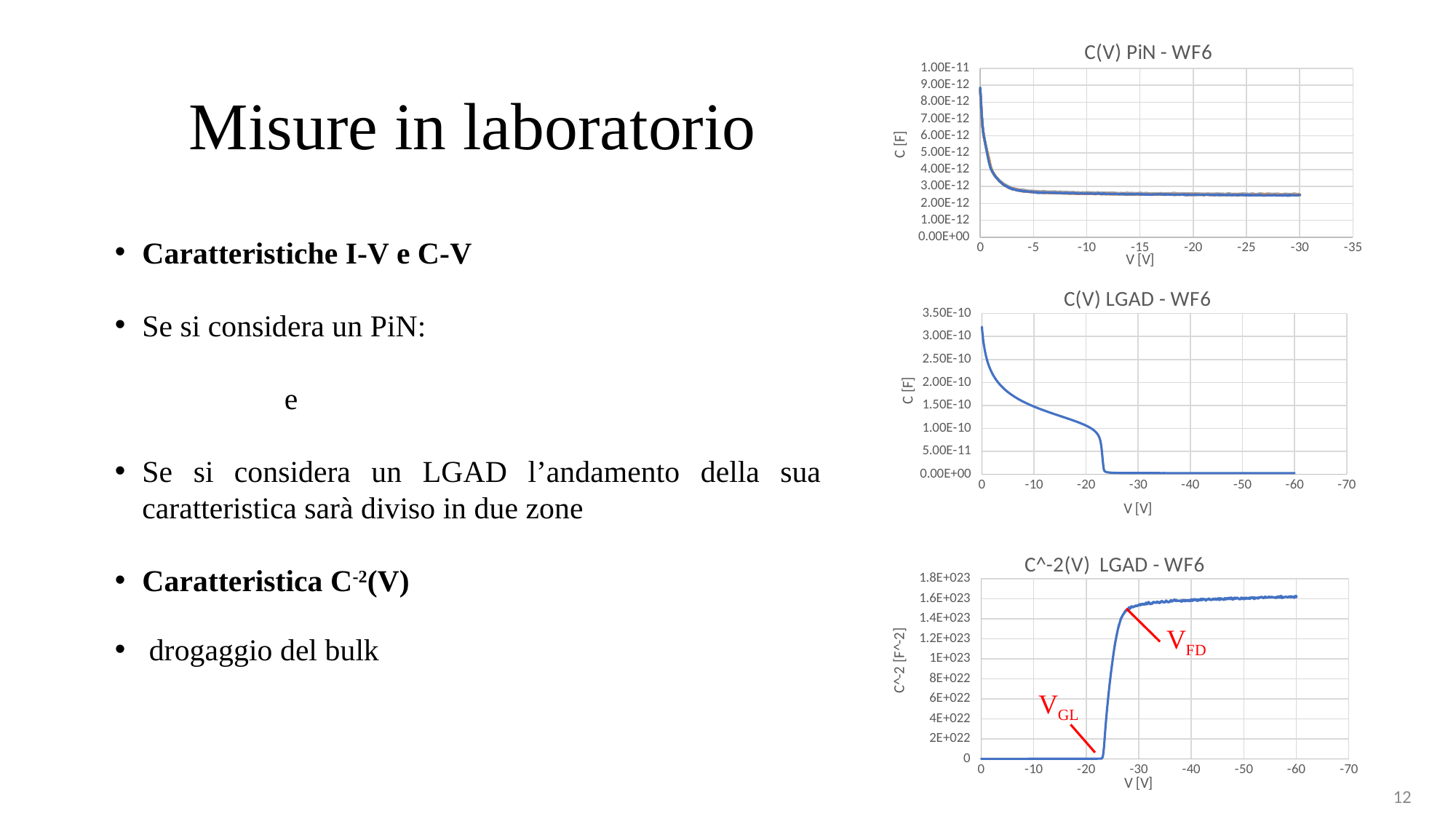
In the "C(V) PiN - WF6" chart, does the capacitance rise or fall as the voltage goes from 0 toward -30 V? fall In the "C(V) PiN - WF6" chart, is the capacitance at 0 V greater or less than 5.00E-12? greater How many charts are shown on the slide? 3 In the "C^-2(V) LGAD - WF6" chart, does the curve rise or fall as the voltage goes from 0 toward -60 V? rise In the "C^-2(V) LGAD - WF6" chart, is the value at -60 V greater or less than 1.4E+023? greater In the "C(V) LGAD - WF6" chart, is the capacitance at 0 V greater or less than 2.50E-10? greater What kind of chart is the "C(V) PiN - WF6" chart? line chart What is the y-axis label of the "C^-2(V) LGAD - WF6" chart? C^-2 [F^-2] In the "C(V) LGAD - WF6" chart, does the capacitance rise or fall as the voltage goes from 0 toward -60 V? fall